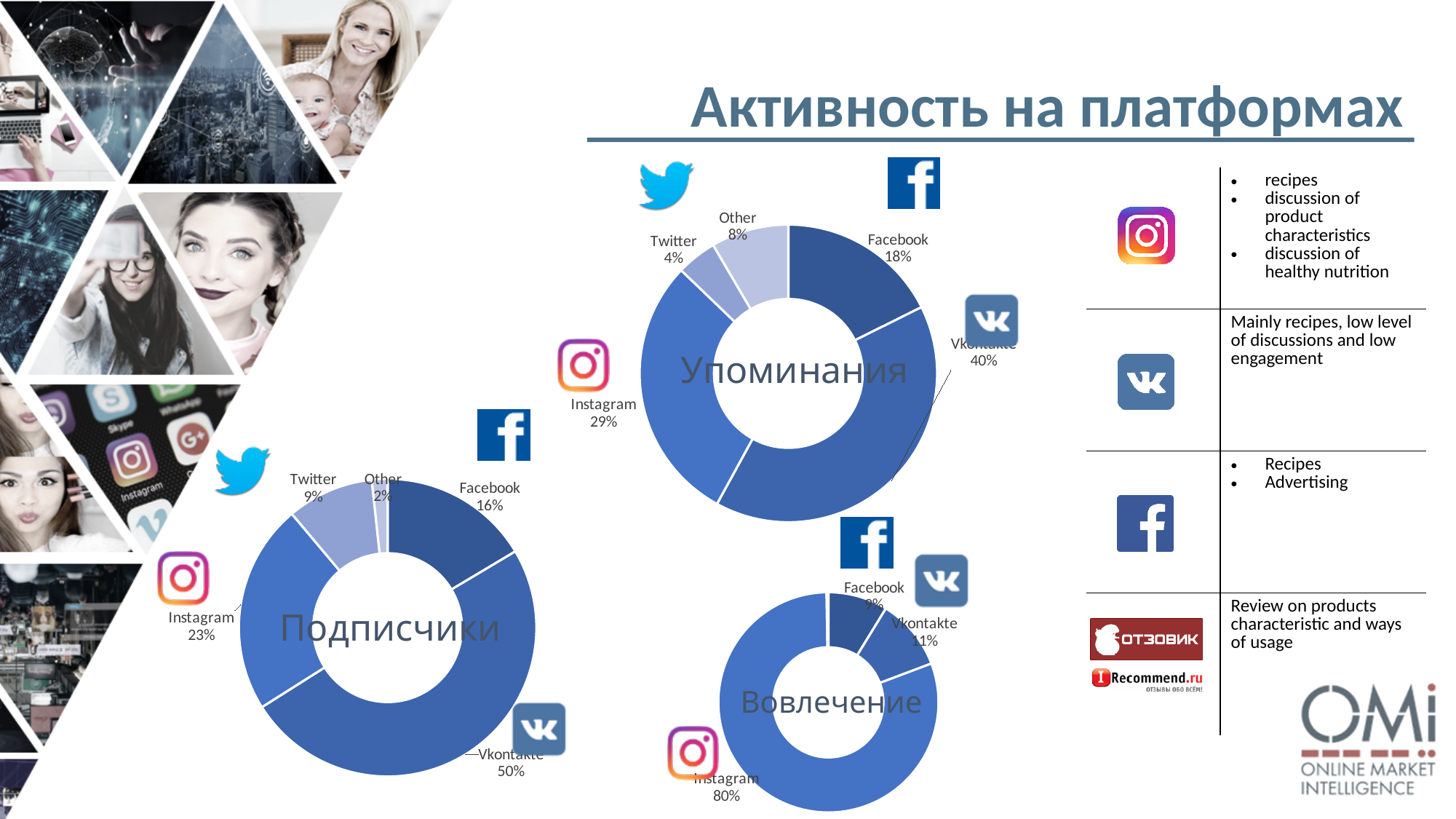
In the Вовлечение chart, what share is Vkontakte? 11% In the Подписчики chart, what share is Vkontakte? 50% In the Подписчики chart, how many categories are shown? 5 In the Упоминания chart, what share is Vkontakte? 40% In the Упоминания chart, what share is Instagram? 29% In the Подписчики chart, what share is Twitter? 9% In the Упоминания chart, which platform has the smallest share? Twitter In the Подписчики chart, which is larger, Instagram or Facebook? Instagram What type of chart is the Вовлечение chart? Doughnut (pie) chart In the Вовлечение chart, what share is Instagram? 80% In the Упоминания chart, what is the difference between the Vkontakte and Facebook shares? 22% In the Подписчики chart, which platform has the largest share? Vkontakte